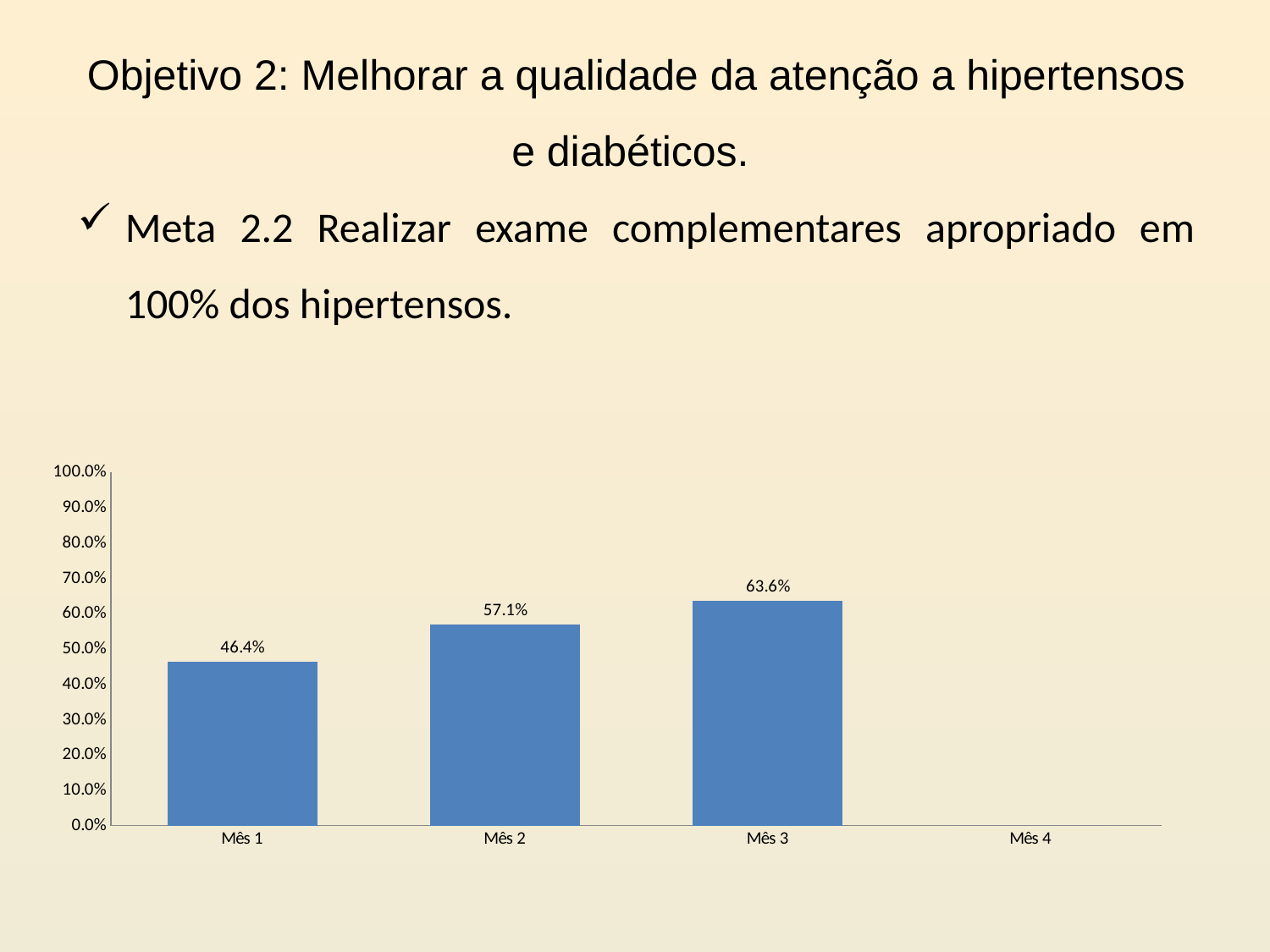
Which is larger, the value for Mês 2 or the value for Mês 3? Mês 3 What is the difference between the values for Mês 2 and Mês 1? 10.7% Which month has the lowest value among the plotted bars? Mês 1 What is the difference between the values for Mês 3 and Mês 1? 17.2% How many categories are shown on the x axis? 4 Do the values rise or fall from Mês 1 to Mês 3? rise What kind of chart is shown on the slide? bar chart What is the value for Mês 1? 46.4% What is the value for Mês 3? 63.6% What is the value for Mês 2? 57.1% Is the value for Mês 1 greater or less than 50.0%? less Which month has the highest value among the plotted bars? Mês 3